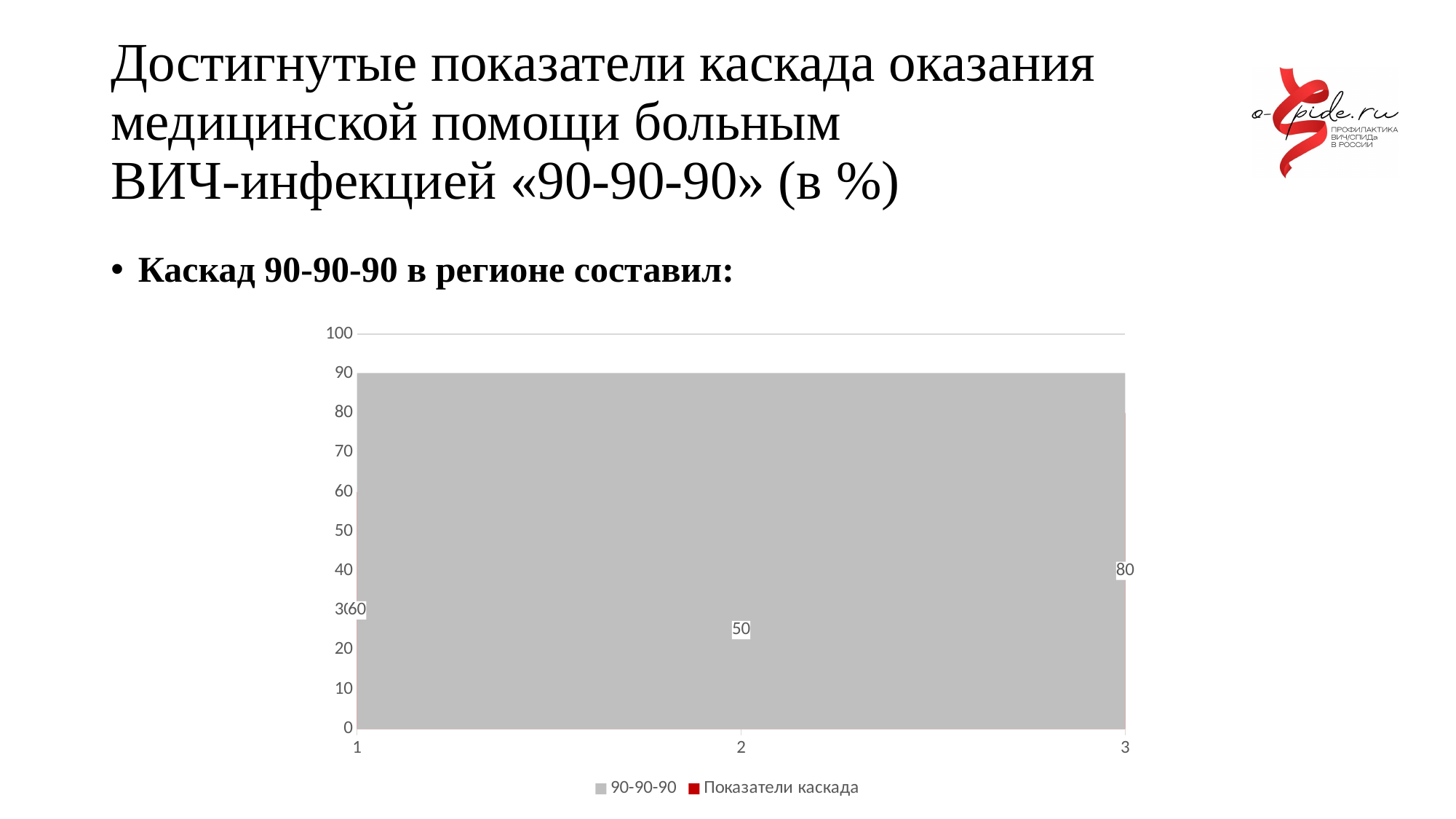
How many points are plotted along the x axis? 3 What is the value of the Показатели каскада series at point 2? 50 What is the difference between the Показатели каскада values at point 3 and point 2? 30 What is the value of the Показатели каскада series at point 3? 80 Does the Показатели каскада series rise or fall from point 2 to point 3? rise How many series does the legend list? 2 At which point on the x axis does the Показатели каскада series have its lowest value? 2 What is the value of the Показатели каскада series at point 1? 60 Is the value of the Показатели каскада series at point 2 greater or less than 60? less At which point on the x axis does the Показатели каскада series reach its highest value? 3 Which is larger for the Показатели каскада series: the value at point 1 or at point 3? point 3 What kind of chart is shown on the slide? area chart